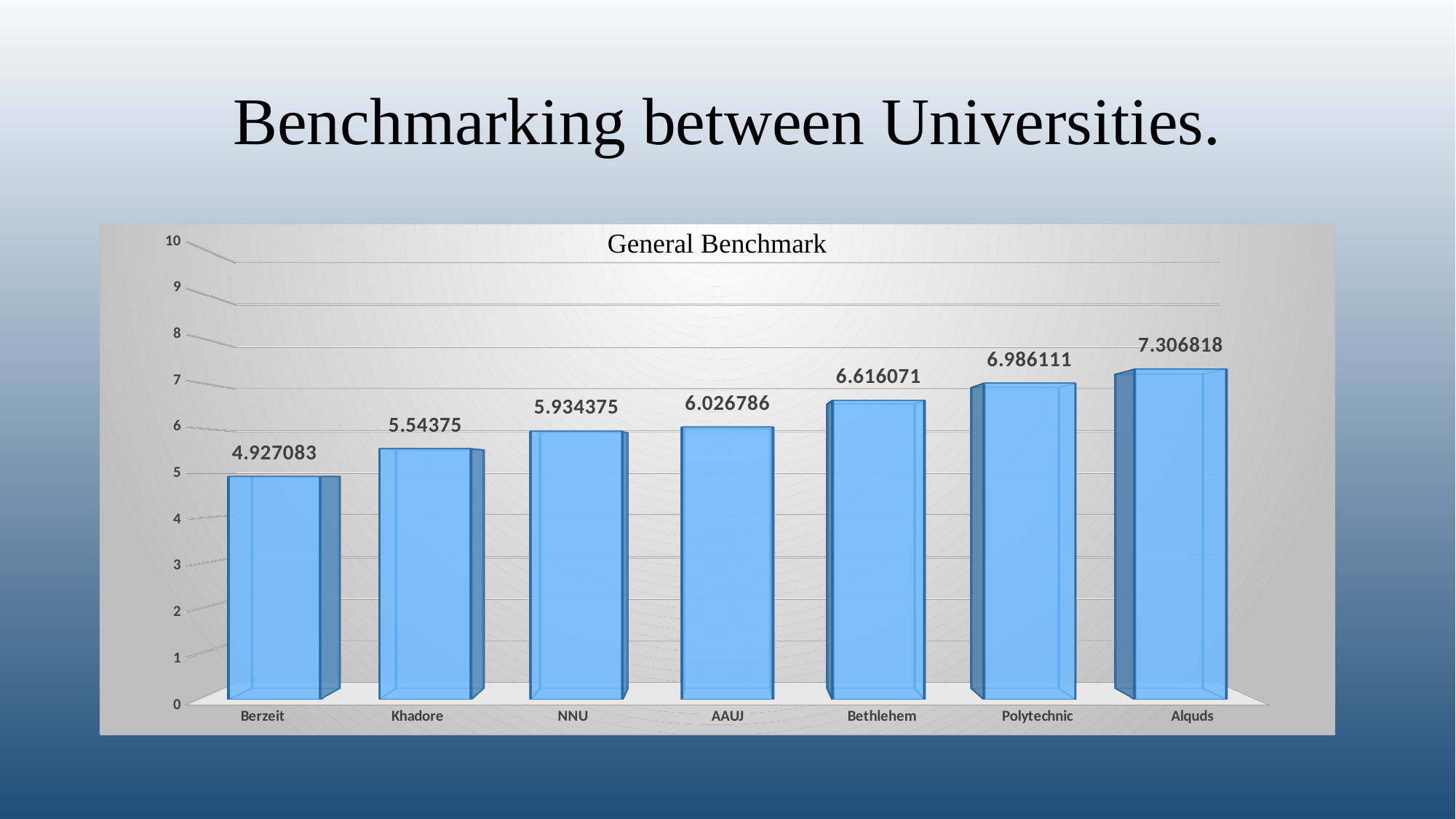
What is the difference between the values for Polytechnic and Bethlehem? 0.37004 How many universities are shown in the General Benchmark chart? 7 Which university has the lowest value in the General Benchmark chart? Berzeit What is the difference between the values for Alquds and Berzeit? 2.379735 What is the value for Bethlehem in the General Benchmark chart? 6.616071 Is the value for NNU greater or less than 6? less Which university has the highest value in the General Benchmark chart? Alquds What kind of chart is shown on the slide? bar chart Do the values rise or fall from Berzeit to Alquds along the x axis? rise What is the value for Polytechnic in the General Benchmark chart? 6.986111 Which has a larger value, Khadore or Bethlehem? Bethlehem What is the value for Berzeit in the General Benchmark chart? 4.927083